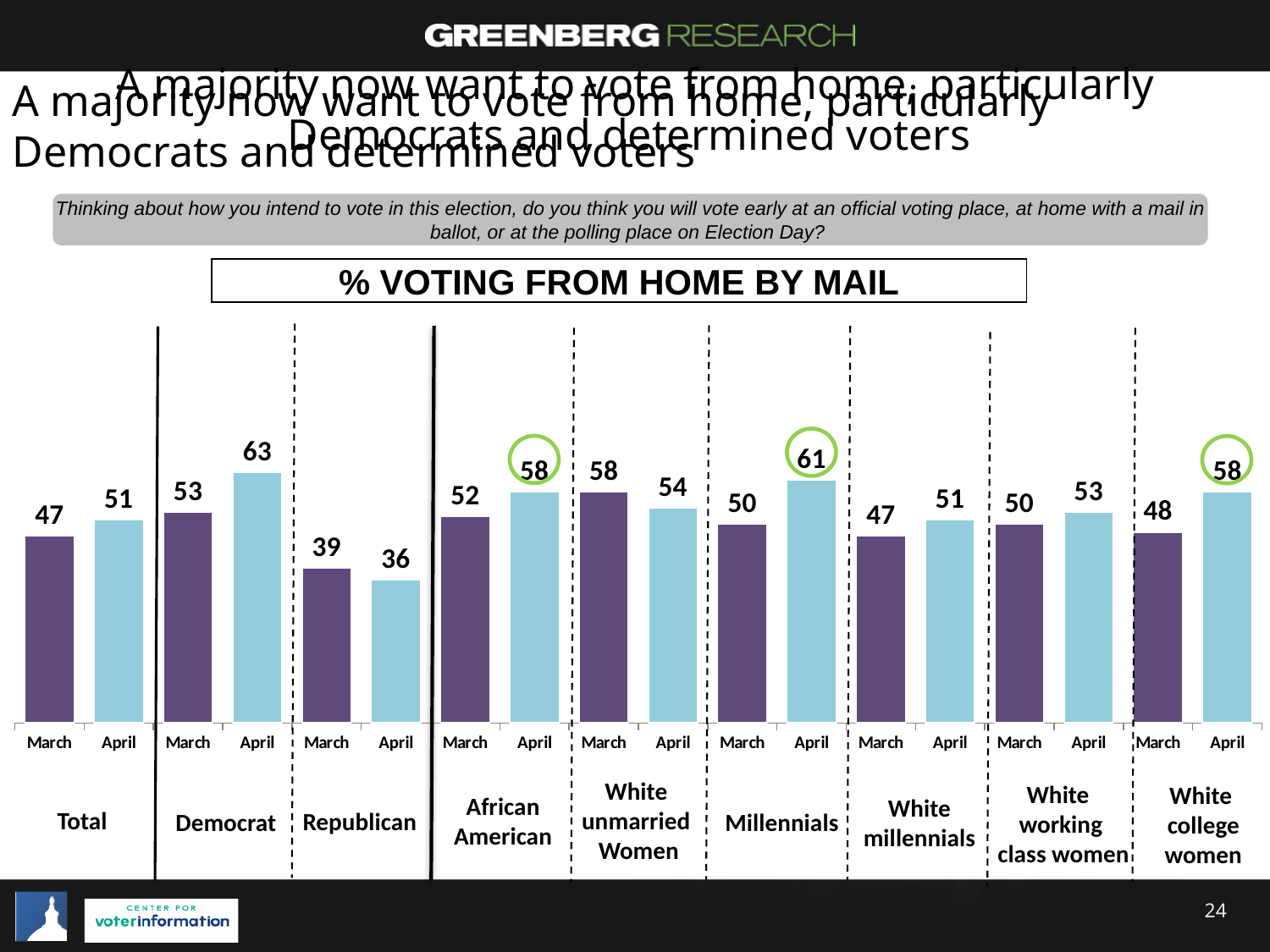
What is the March value for Republican? 39 Which group has the lowest April value? Republican What kind of chart is shown on the slide? Bar chart What is the April value for Millennials? 61 Which is larger for Republican, the March value or the April value? March What is the difference between the March and April values for White college women? 10 What is the April value for Democrat in the % Voting From Home By Mail chart? 63 Which group has the highest April value? Democrat What is the title of the chart? % VOTING FROM HOME BY MAIL How many groups are shown along the x axis of the chart? 9 What is the March value for White unmarried Women? 58 What is the difference between the April and March values for Democrat? 10